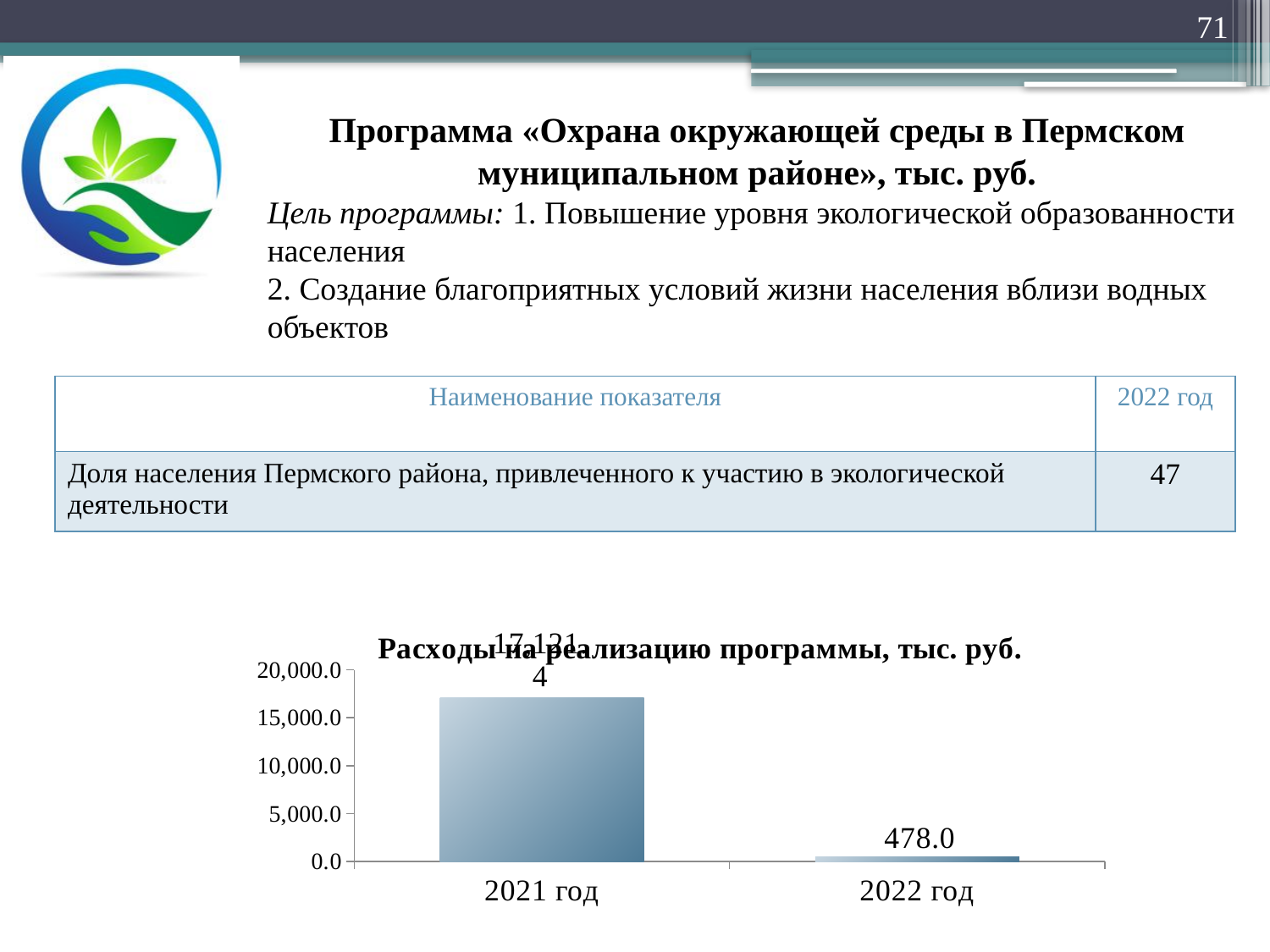
Which year has the lowest value in the chart? 2022 год What is the value for 2022 год in the chart? 478.0 What kind of chart is shown on the slide? bar chart Which year has the highest value in the chart? 2021 год How many categories (years) are plotted in the chart? 2 Which is larger, the value for 2021 год or the value for 2022 год? 2021 год What is the highest tick value shown on the vertical axis of the chart? 20,000.0 What is the title of the chart? Расходы на реализацию программы, тыс. руб. Is the value for 2022 год greater or less than 5,000.0? less Do the values rise or fall from 2021 год to 2022 год? fall Is the value for 2021 год greater or less than 15,000.0? greater